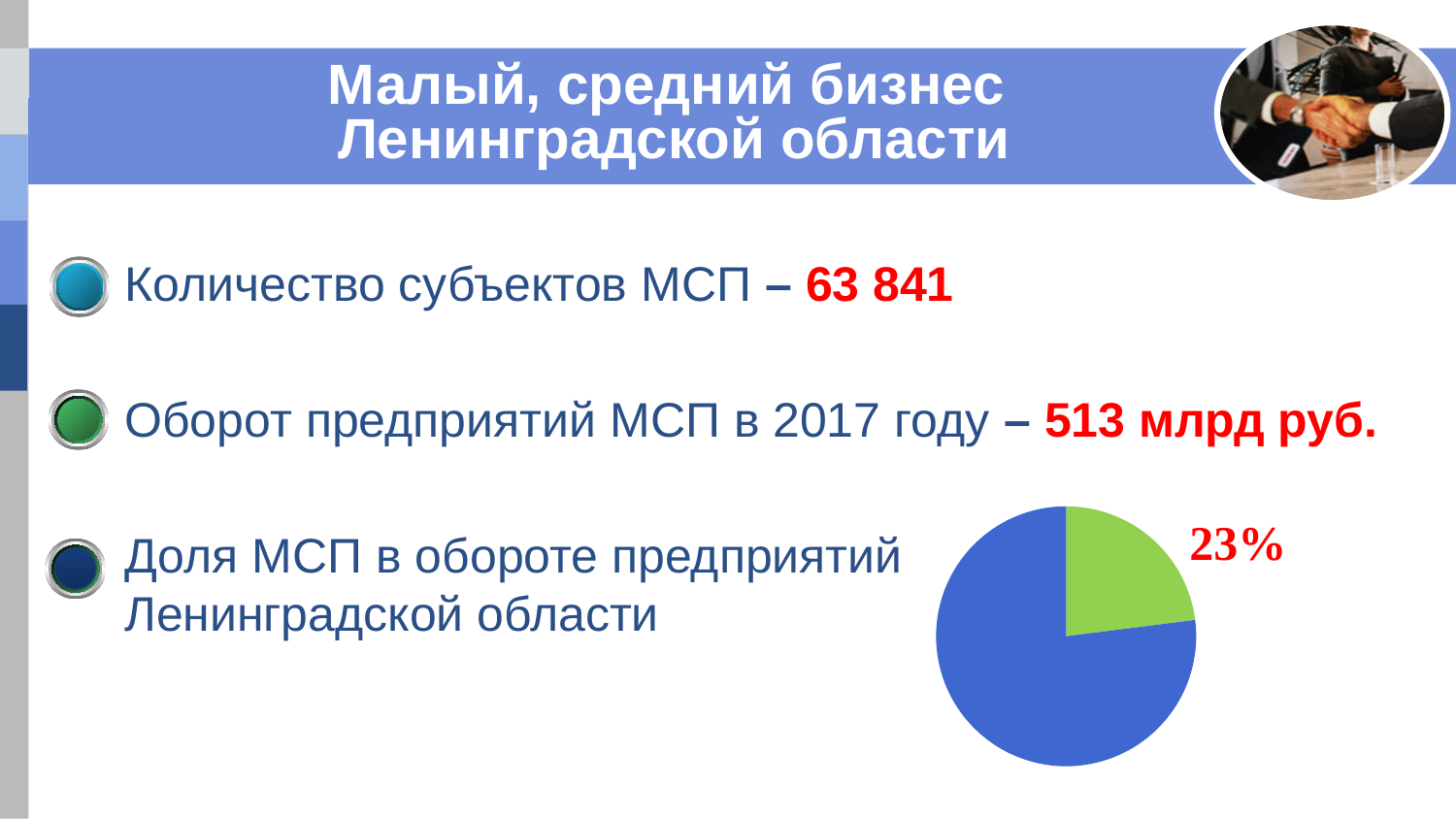
Which slice of the pie chart is larger, the blue one or the green one? blue What colour is the slice labelled 23% in the pie chart? green What kind of chart is shown on the slide? pie chart What does the pie chart illustrate, according to the text next to it? Доля МСП в обороте предприятий Ленинградской области Which slice of the pie chart is the smallest? the green slice (23%) How many slices does the pie chart have? 2 What share of the pie does the green slice represent? 23%